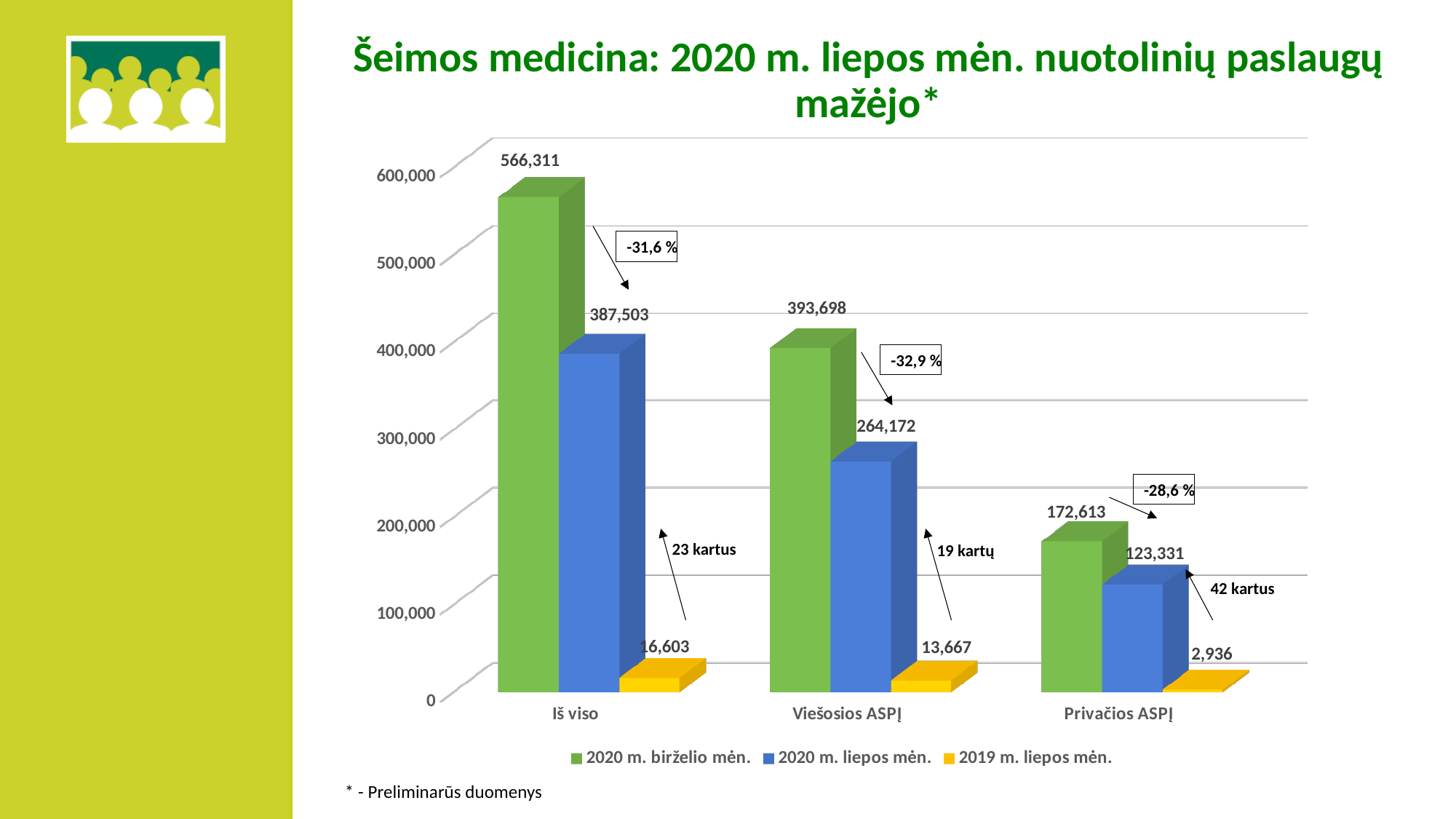
Is the 2020 m. liepos mėn. value for Viešosios ASPĮ greater or less than 300,000? less What is the value for 2020 m. liepos mėn. in the Viešosios ASPĮ category? 264,172 What is the difference between the 2020 m. birželio mėn. and 2020 m. liepos mėn. values for Privačios ASPĮ? 49,282 Which category has the highest value for 2020 m. liepos mėn.? Iš viso What is the value for 2019 m. liepos mėn. in the Privačios ASPĮ category? 2,936 What is the value for 2020 m. birželio mėn. in the Iš viso category? 566,311 How many series does the legend list? 3 What kind of chart is shown on the slide? bar chart Which is larger: the 2019 m. liepos mėn. value for Iš viso or for Viešosios ASPĮ? Iš viso How many categories are shown on the x axis? 3 What percentage change is annotated for the Viešosios ASPĮ category? -32,9 % Which category has the lowest value for 2020 m. birželio mėn.? Privačios ASPĮ